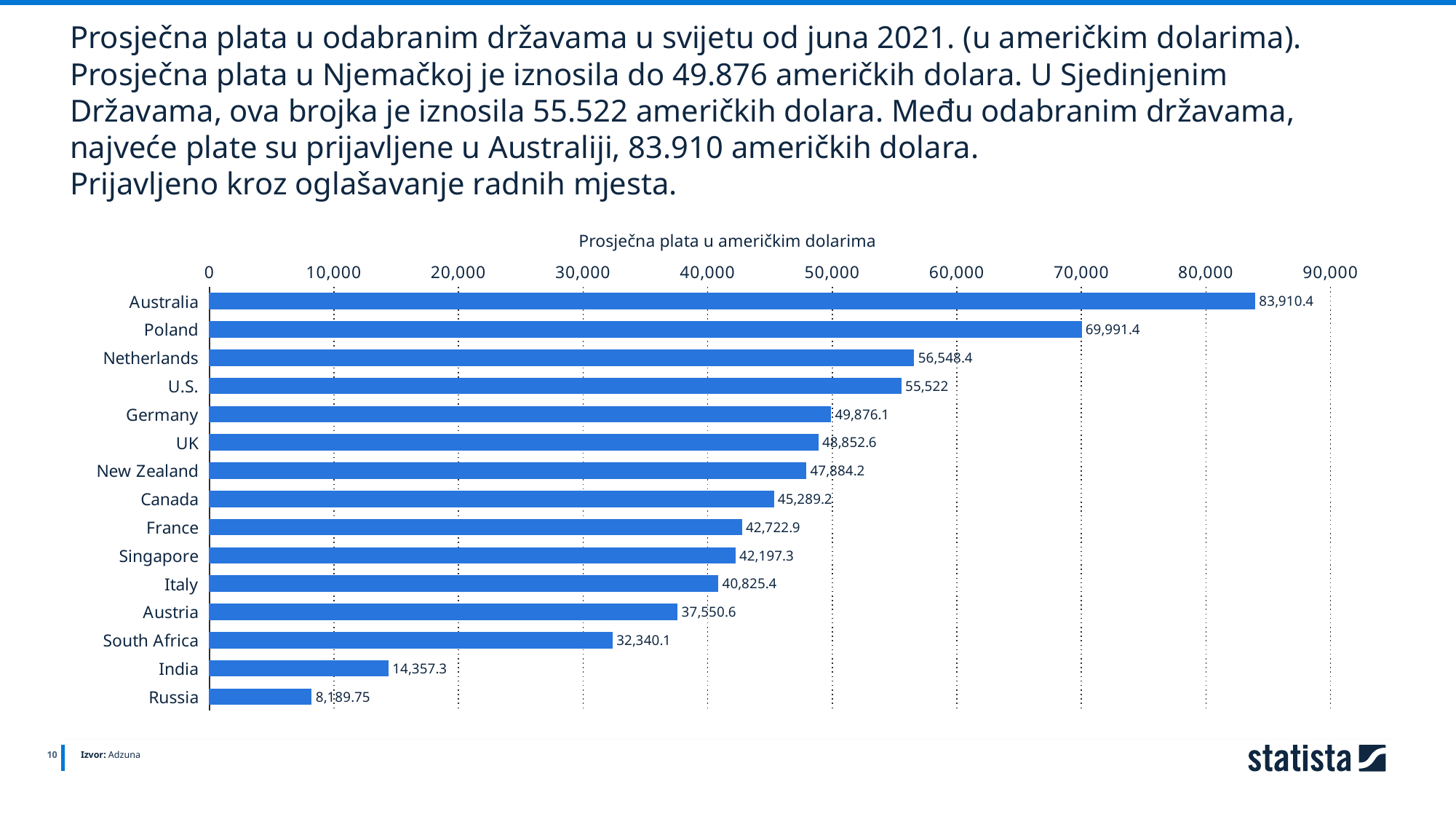
What is the title of the horizontal axis of the chart? Prosječna plata u američkim dolarima What is the average salary shown for Germany? 49,876.1 Which country has the highest average salary in the chart? Australia Which has a higher average salary, Canada or France? Canada What is the difference between the average salaries of Australia and Poland? 13,919 What is the average salary shown for Australia? 83,910.4 How many countries are shown in the chart? 15 Which country has the lowest average salary in the chart? Russia What is the difference between the average salaries of the U.S. and Germany? 5,645.9 Is the value for Austria greater or less than 40,000? less What is the average salary shown for Russia? 8,189.75 What kind of chart is shown on the slide? bar chart